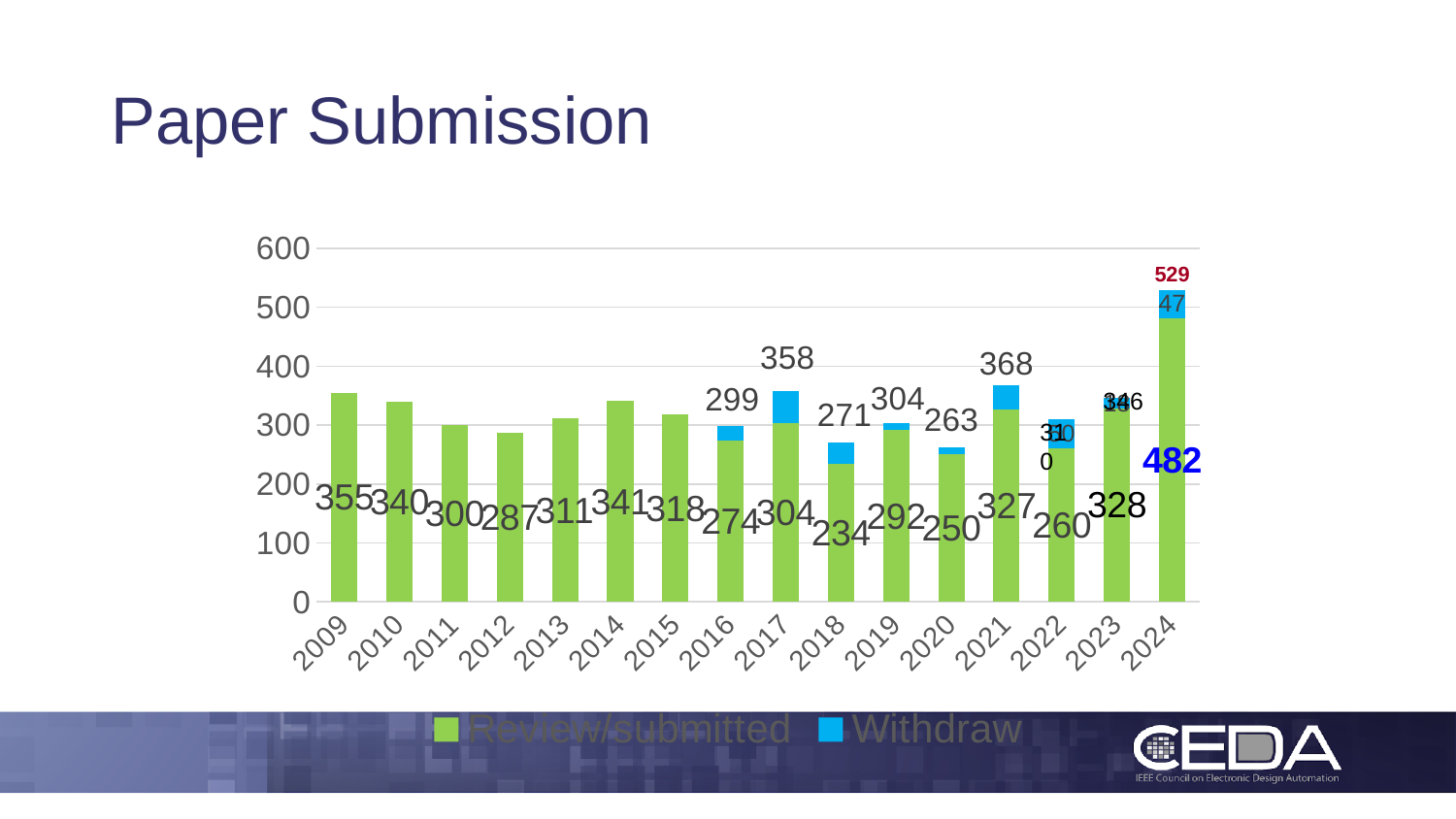
What is the Review/submitted value for 2009? 355 What is the Review/submitted value for 2024? 482 Which year has the lowest Review/submitted value? 2018 Which year has the larger Review/submitted value, 2014 or 2015? 2014 What is the difference between the Review/submitted values for 2009 and 2010? 15 Do the Review/submitted values rise or fall from 2009 to 2012? Fall What kind of chart is shown on the slide? Stacked bar chart What is the Withdraw value for 2024? 47 How many years are shown on the x axis of the chart? 16 What is the total height of the stacked bar for 2024? 529 How many series does the chart legend list? 2 Which year has the highest Review/submitted value? 2024